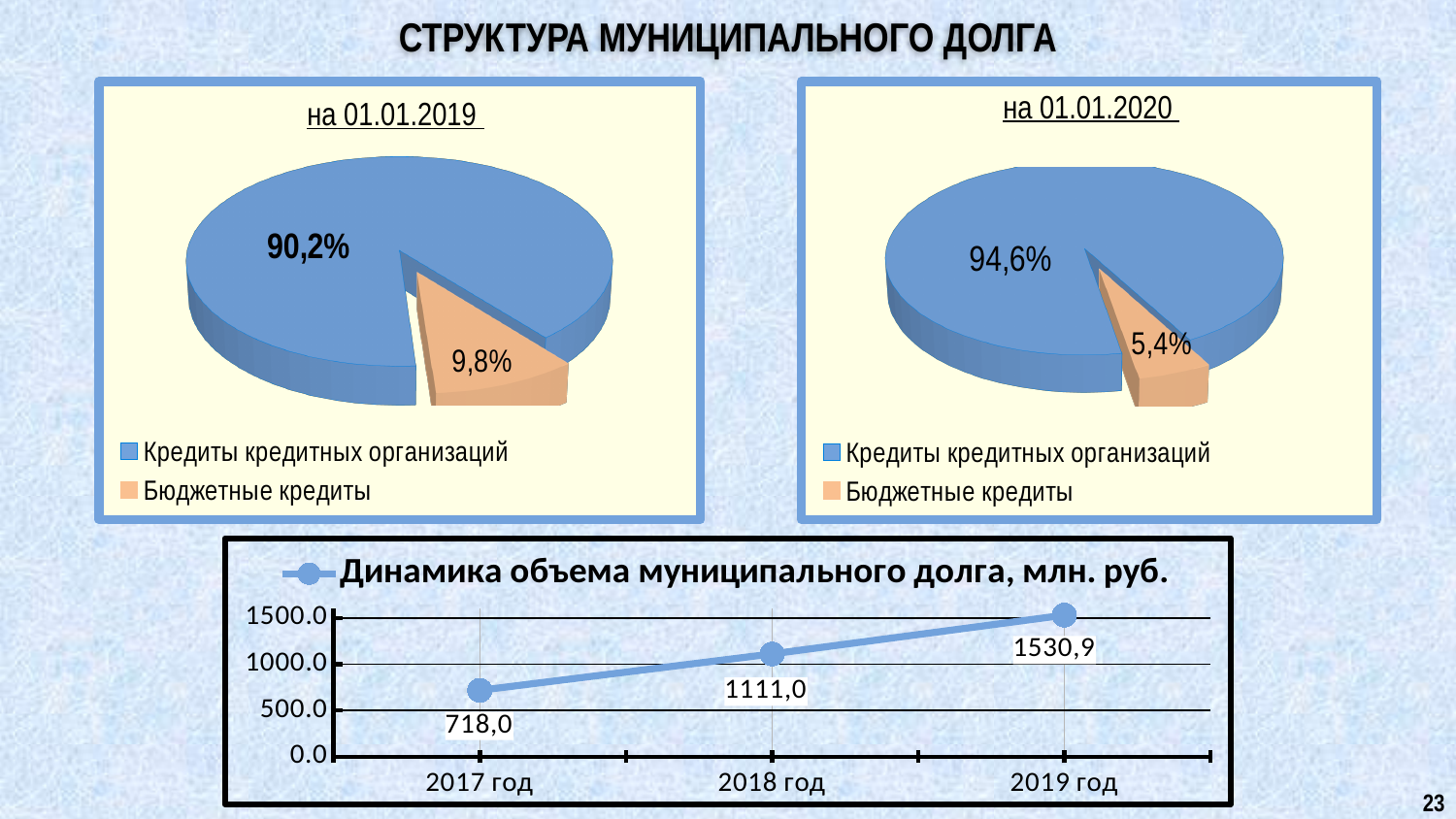
In the pie chart 'на 01.01.2020', what share is 'Бюджетные кредиты'? 5,4% In the chart 'Динамика объема муниципального долга, млн. руб.', what is the difference between the values for '2018 год' and '2017 год'? 393,0 What kind of chart is 'Динамика объема муниципального долга, млн. руб.'? line chart In the chart 'Динамика объема муниципального долга, млн. руб.', what is the value for '2017 год'? 718,0 In the pie chart 'на 01.01.2020', what share is 'Кредиты кредитных организаций'? 94,6% In the chart 'Динамика объема муниципального долга, млн. руб.', what is the value for '2019 год'? 1530,9 In the chart 'Динамика объема муниципального долга, млн. руб.', do the values rise or fall from 2017 год to 2019 год? rise In the chart 'Динамика объема муниципального долга, млн. руб.', how many data points are plotted? 3 In the pie chart 'на 01.01.2019', how many slices does the pie have? 2 In the pie chart 'на 01.01.2019', what share is 'Кредиты кредитных организаций'? 90,2% In the pie chart 'на 01.01.2020', which category has the largest slice? Кредиты кредитных организаций